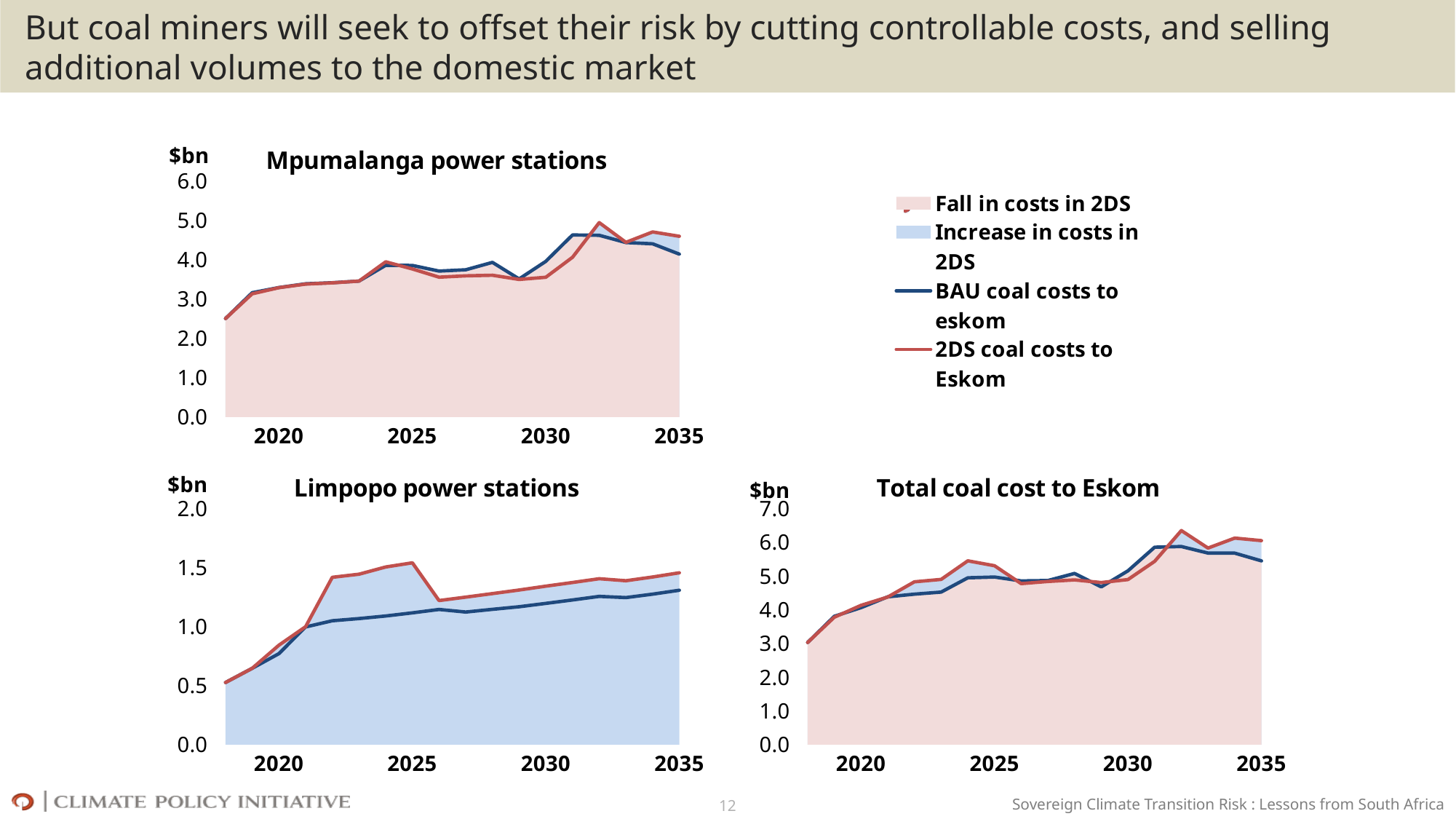
In the 'Mpumalanga power stations' chart, which series is higher in 2035: BAU coal costs to eskom or 2DS coal costs to Eskom? 2DS coal costs to Eskom What is the highest y-axis tick value on the 'Total coal cost to Eskom' chart? 7.0 In the 'Total coal cost to Eskom' chart, does the BAU coal costs to eskom line generally rise or fall from 2020 to 2035? Rise In the 'Limpopo power stations' chart, which series is higher in 2025: BAU coal costs to eskom or 2DS coal costs to Eskom? 2DS coal costs to Eskom What kind of chart is the 'Mpumalanga power stations' chart? Line chart with shaded area In the 'Mpumalanga power stations' chart, is the BAU coal costs to eskom value for 2020 greater or less than 3.0? greater How many charts are shown on the slide? 3 How many series does the legend on the slide list? 4 In the 'Total coal cost to Eskom' chart, is the BAU coal costs to eskom value for 2035 greater or less than 5.0? greater In the 'Limpopo power stations' chart, is the BAU coal costs to eskom value for 2020 greater or less than 0.5? greater What unit is shown on the y axis of the 'Limpopo power stations' chart? $bn